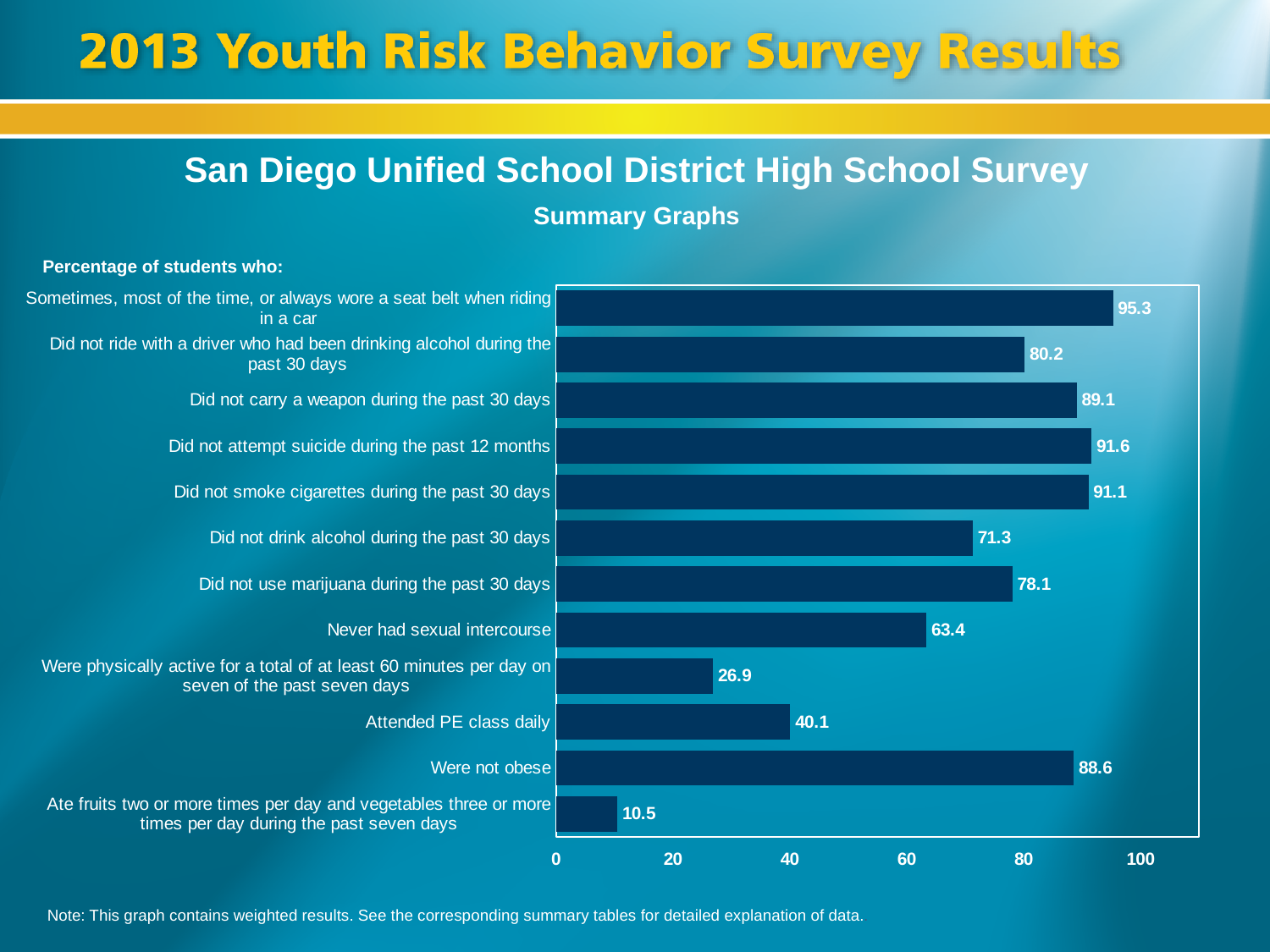
What kind of chart is shown on the slide? Bar chart What percentage of students did not carry a weapon during the past 30 days? 89.1 Which category has the highest value on the chart? Sometimes, most of the time, or always wore a seat belt when riding in a car What percentage of students attended PE class daily? 40.1 What is the difference between the percentage who did not use marijuana during the past 30 days and the percentage who did not drink alcohol during the past 30 days? 6.8 Which is larger: the percentage who were not obese or the percentage who did not ride with a driver who had been drinking alcohol during the past 30 days? Were not obese How many categories are shown on the chart? 12 What is the subtitle shown above the chart? Summary Graphs What is the maximum value shown on the horizontal axis? 100 Is the value for students who were physically active for at least 60 minutes per day on seven of the past seven days greater or less than 40? less Which category has the lowest value on the chart? Ate fruits two or more times per day and vegetables three or more times per day during the past seven days What percentage of students never had sexual intercourse? 63.4